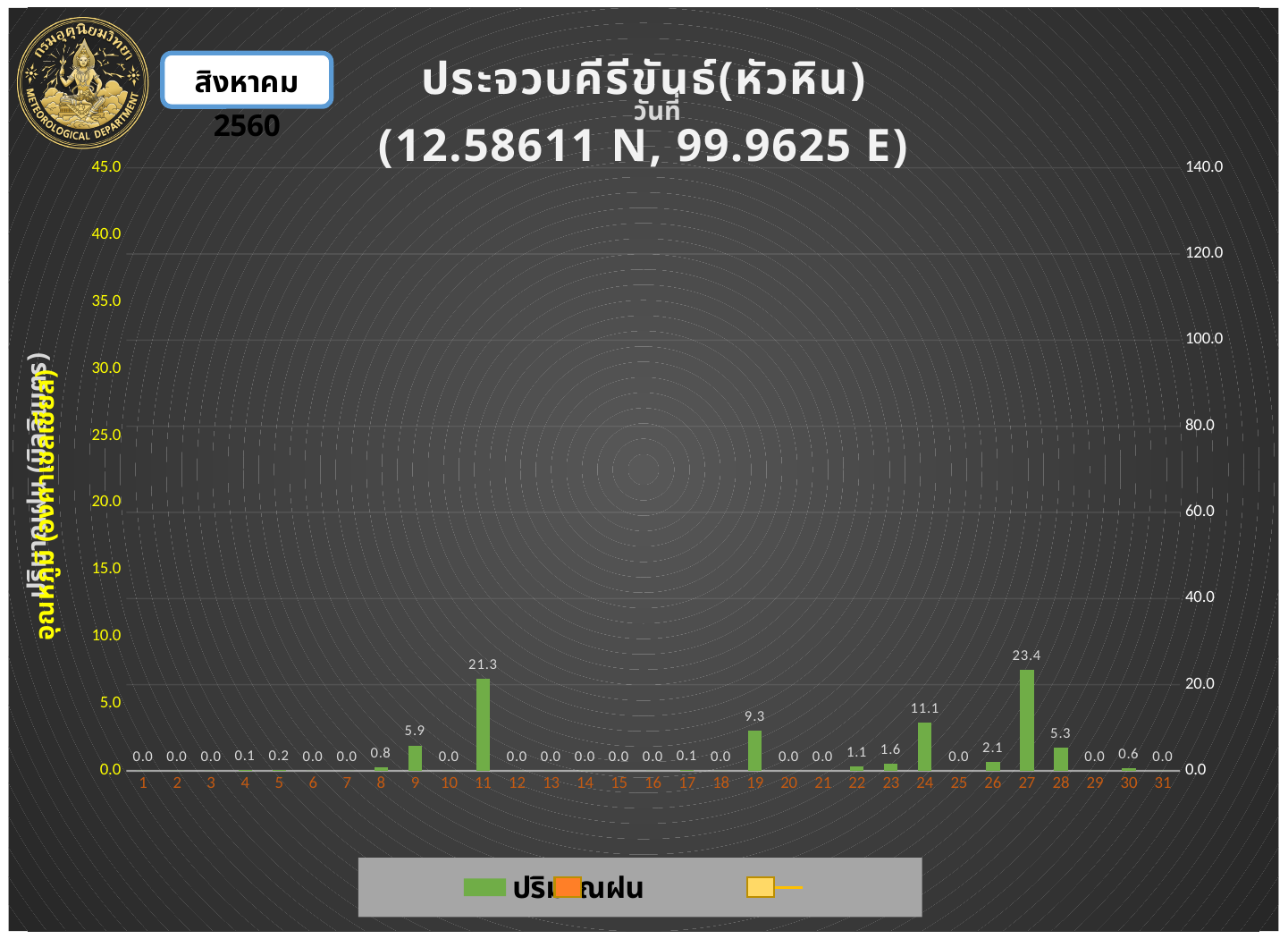
Which day has the larger rainfall value, day 24 or day 19? 24 What is the rainfall value shown for day 11? 21.3 What is the rainfall value shown for day 9? 5.9 What is the rainfall value shown for day 27? 23.4 Which day has the larger rainfall value, day 9 or day 28? 9 Which day has the highest rainfall value? 27 What kind of chart is shown on the slide? bar chart What is the rainfall value shown for day 19? 9.3 What is the rainfall value shown for day 24? 11.1 What is the difference between the rainfall values for day 27 and day 11? 2.1 How many days are shown on the x axis of the chart? 31 What month and year are shown in the box at the top left of the slide? สิงหาคม 2560